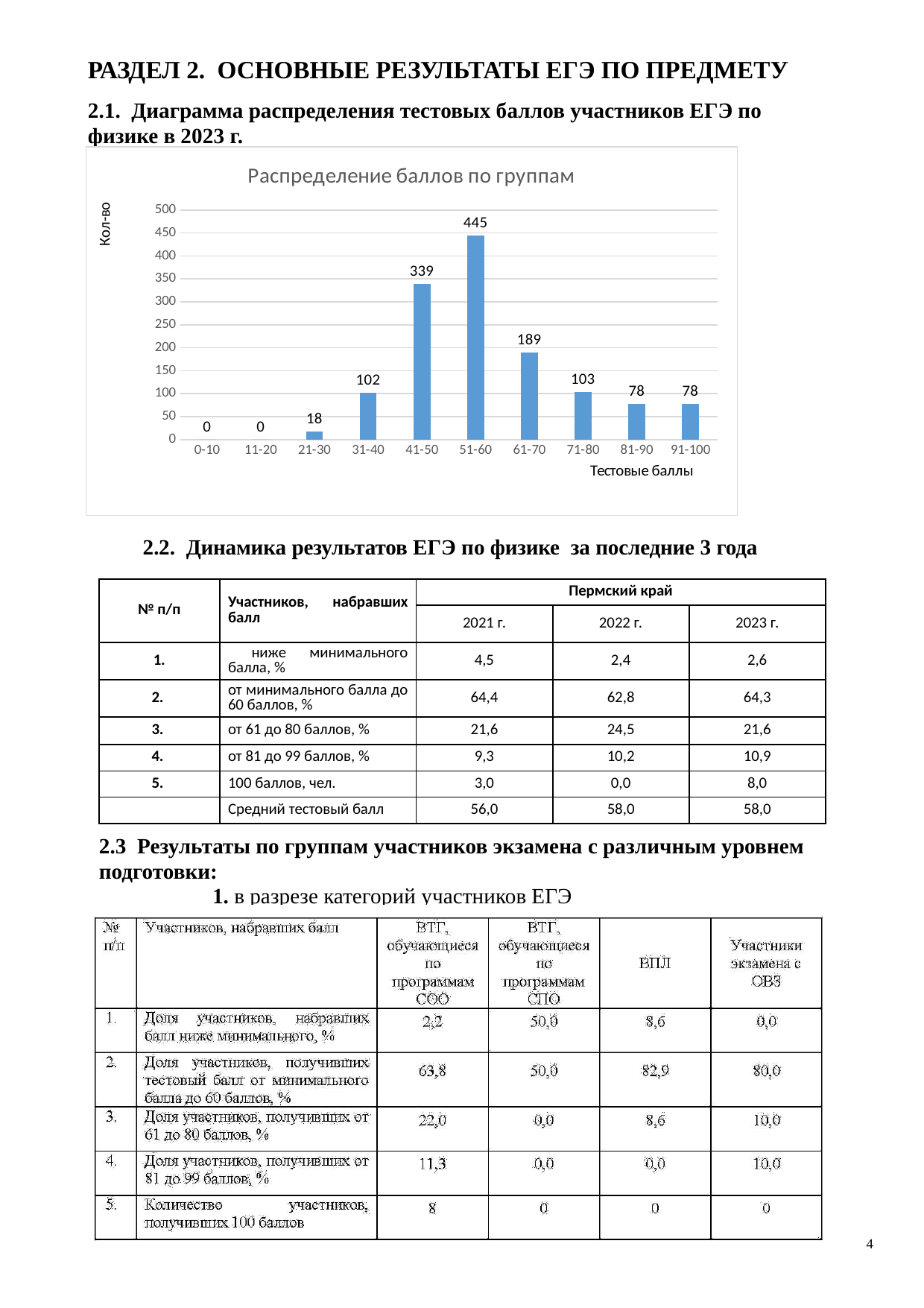
What is the difference between the values for the 51-60 and 41-50 groups? 106 Which is larger, the value for 61-70 or the value for 31-40? 61-70 What type of chart is shown on the slide? bar chart What is the value for the 71-80 score group? 103 How many score groups are shown on the x axis? 10 What is the title of the chart? Распределение баллов по группам What is the difference between the values for the 61-70 and 71-80 groups? 86 What is the label of the vertical axis? Кол-во Which score group has the highest count? 51-60 What is the value for the 41-50 score group? 339 What is the value for the 51-60 score group? 445 What is the value for the 21-30 score group? 18